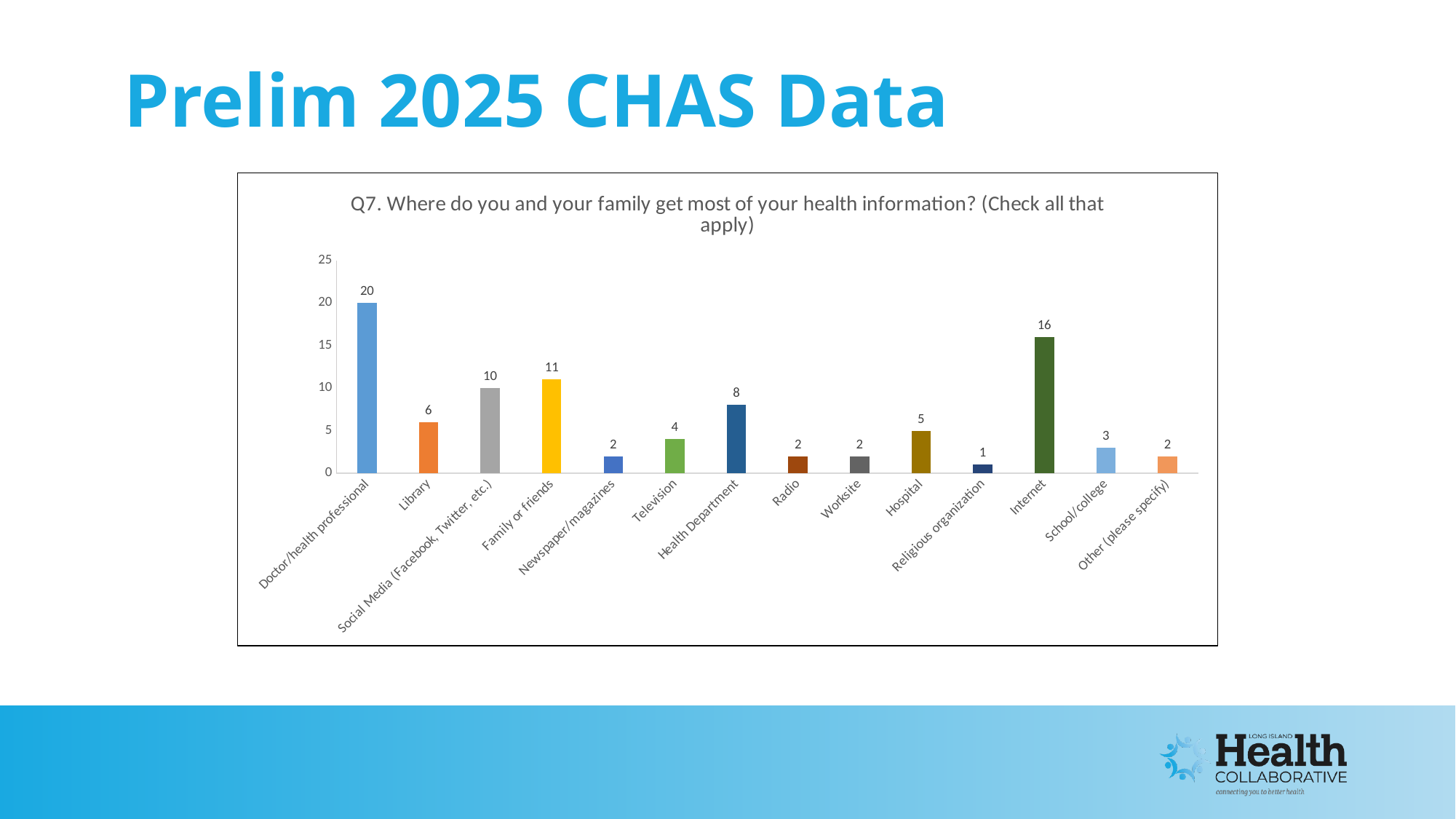
What is the value for Health Department? 8 What kind of chart is shown on the slide? Bar chart How many categories are shown on the x axis? 14 Which category has the highest value? Doctor/health professional Which is larger, the value for Family or friends or the value for Library? Family or friends What is the difference between the values for Doctor/health professional and Internet? 4 What is the value for Doctor/health professional? 20 Which category has the lowest value? Religious organization What is the value for Internet? 16 Is the value for Internet greater or less than 15? greater What is the value for Social Media (Facebook, Twitter, etc.)? 10 What is the title of the chart? Q7. Where do you and your family get most of your health information? (Check all that apply)